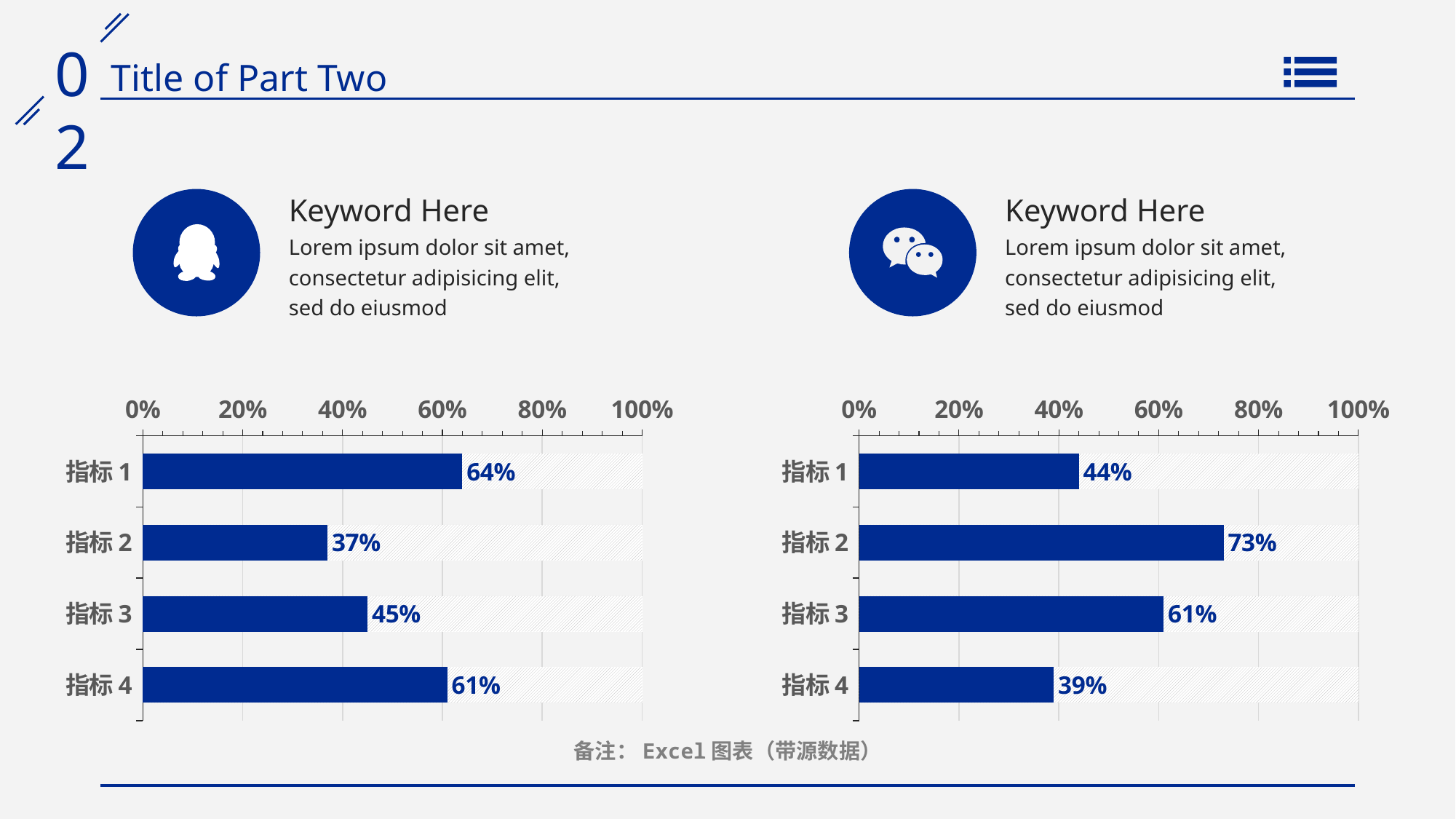
How many categories does the left chart show? 4 In the right chart, is the value for 指标 1 greater or less than 60%? less In the right chart, which category has the lowest value? 指标 4 In the left chart, what is the value for 指标 3? 45% In the right chart, which category has the highest value? 指标 2 In the left chart, what is the value for 指标 1? 64% In the left chart, which is larger, the value for 指标 3 or the value for 指标 4? 指标 4 In the right chart, what is the value for 指标 2? 73% In the left chart, what is the difference between the values for 指标 1 and 指标 2? 27% In the right chart, what is the difference between the values for 指标 2 and 指标 3? 12% In the left chart, which category has the lowest value? 指标 2 What kind of chart is the right chart? bar chart